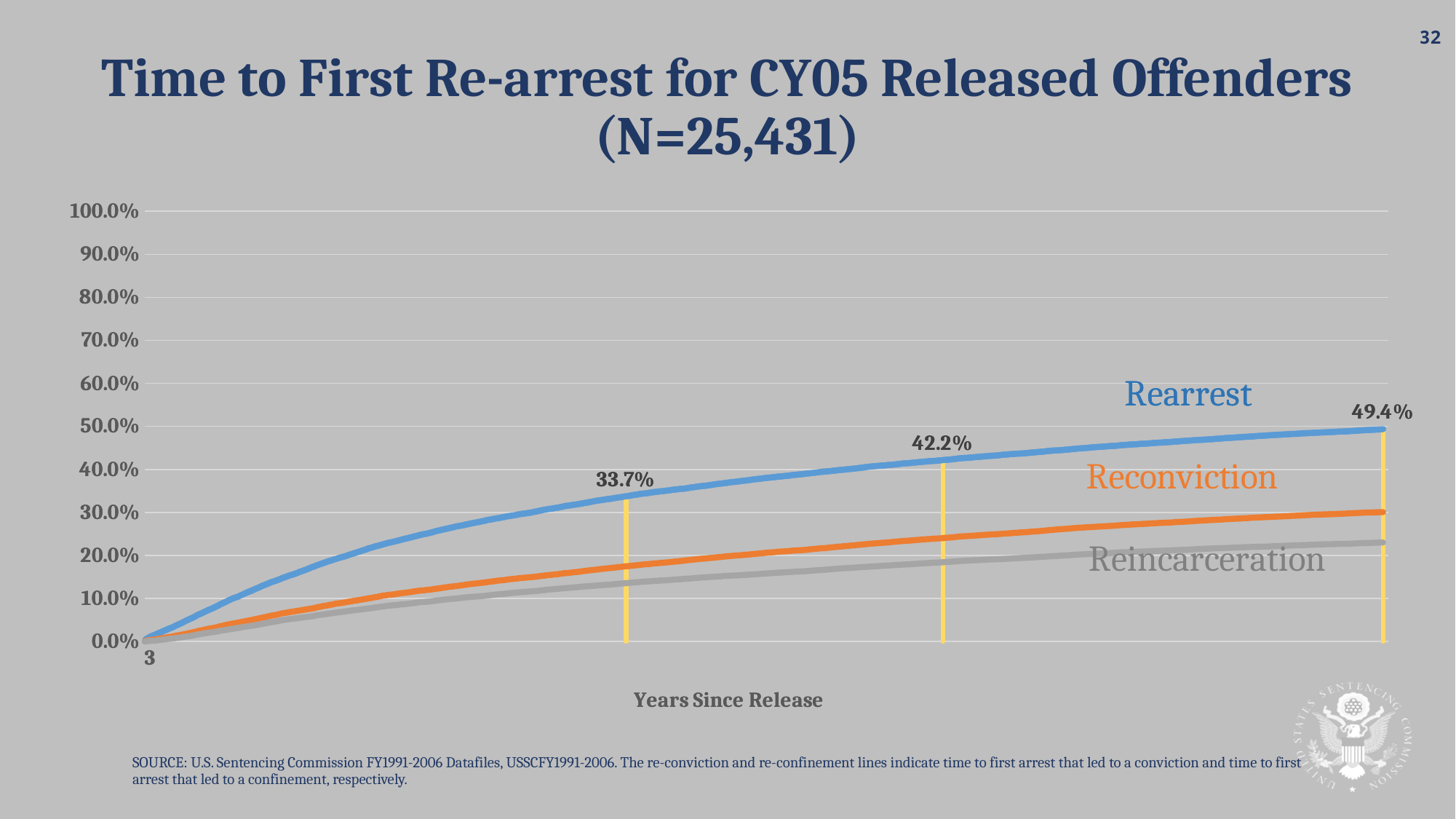
What is the difference between the Rearrest values at the last and middle yellow markers (49.4% and 42.2%)? 7.2 percentage points Do the lines rise or fall as years since release increase? rise What is the value shown at the first yellow marker on the Rearrest line? 33.7% What is the final labeled value of the Rearrest line at the right end of the chart? 49.4% Which line is highest across the chart? Rearrest Which line is lowest across the chart? Reincarceration What kind of chart is shown on the slide? line chart How many series (lines) are plotted on the chart? 3 What is the value shown at the middle yellow marker on the Rearrest line? 42.2% What is the label on the x axis of the chart? Years Since Release Is the Reincarceration line at the right end of the chart greater or less than 30.0%? less What is the difference between the Rearrest values at the middle and first yellow markers (42.2% and 33.7%)? 8.5 percentage points